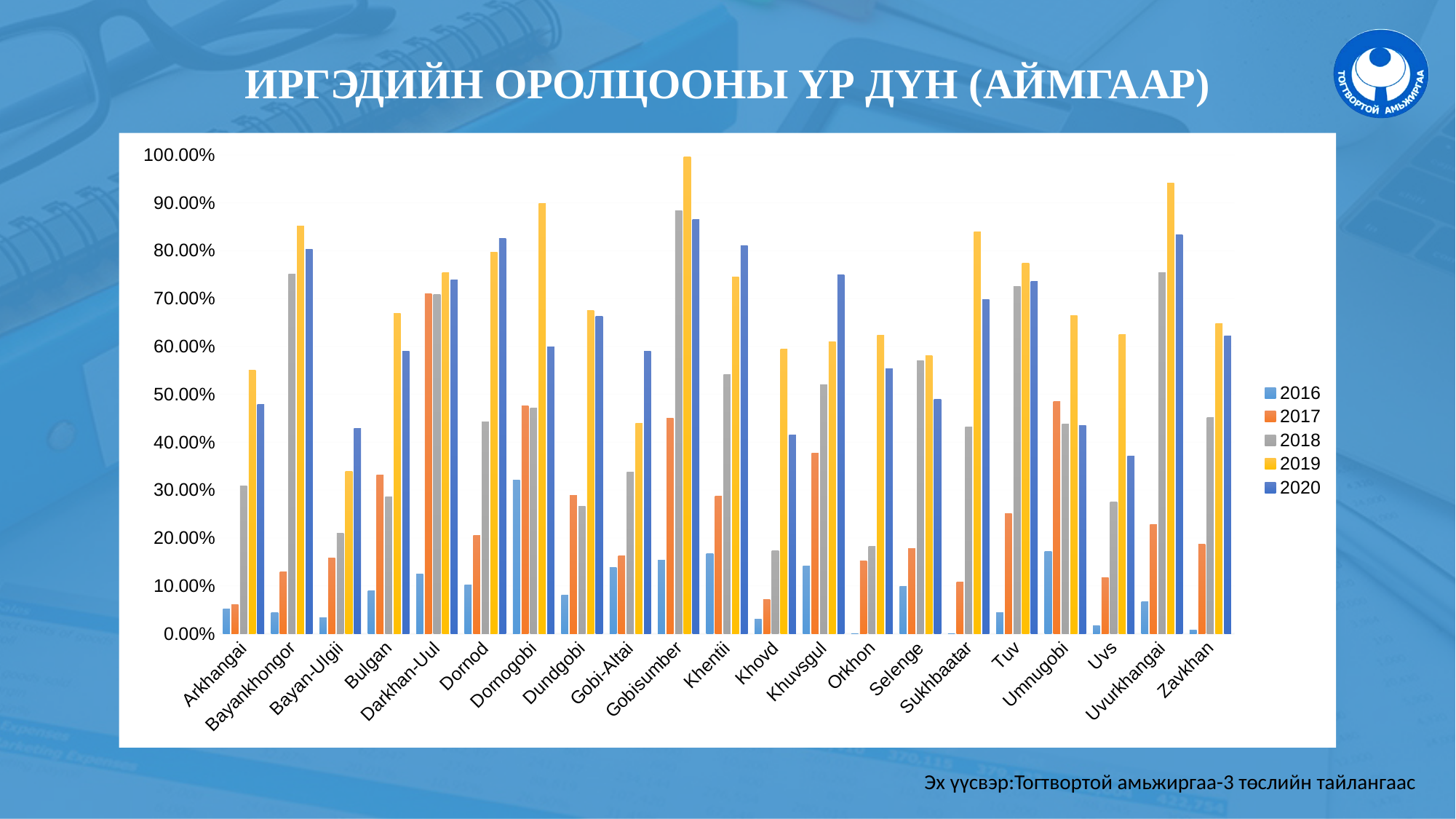
Which category has the highest 2019 value? Gobisumber How many series does the legend list? 5 How many categories (aimags) are shown on the x axis? 21 Is the 2020 value for Khovd greater or less than 50.00%? less Which category has the lowest 2019 value? Bayan-Ulgii Is the 2019 value for Bayankhongor greater or less than 80.00%? greater Which is larger, the 2017 value for Darkhan-Uul or the 2017 value for Dornod? Darkhan-Uul Is the 2019 value for Uvurkhangai greater or less than 90.00%? greater For Bayankhongor, do the values rise or fall from 2016 to 2019? rise Which year is listed first in the legend? 2016 What kind of chart is shown on the slide? bar chart